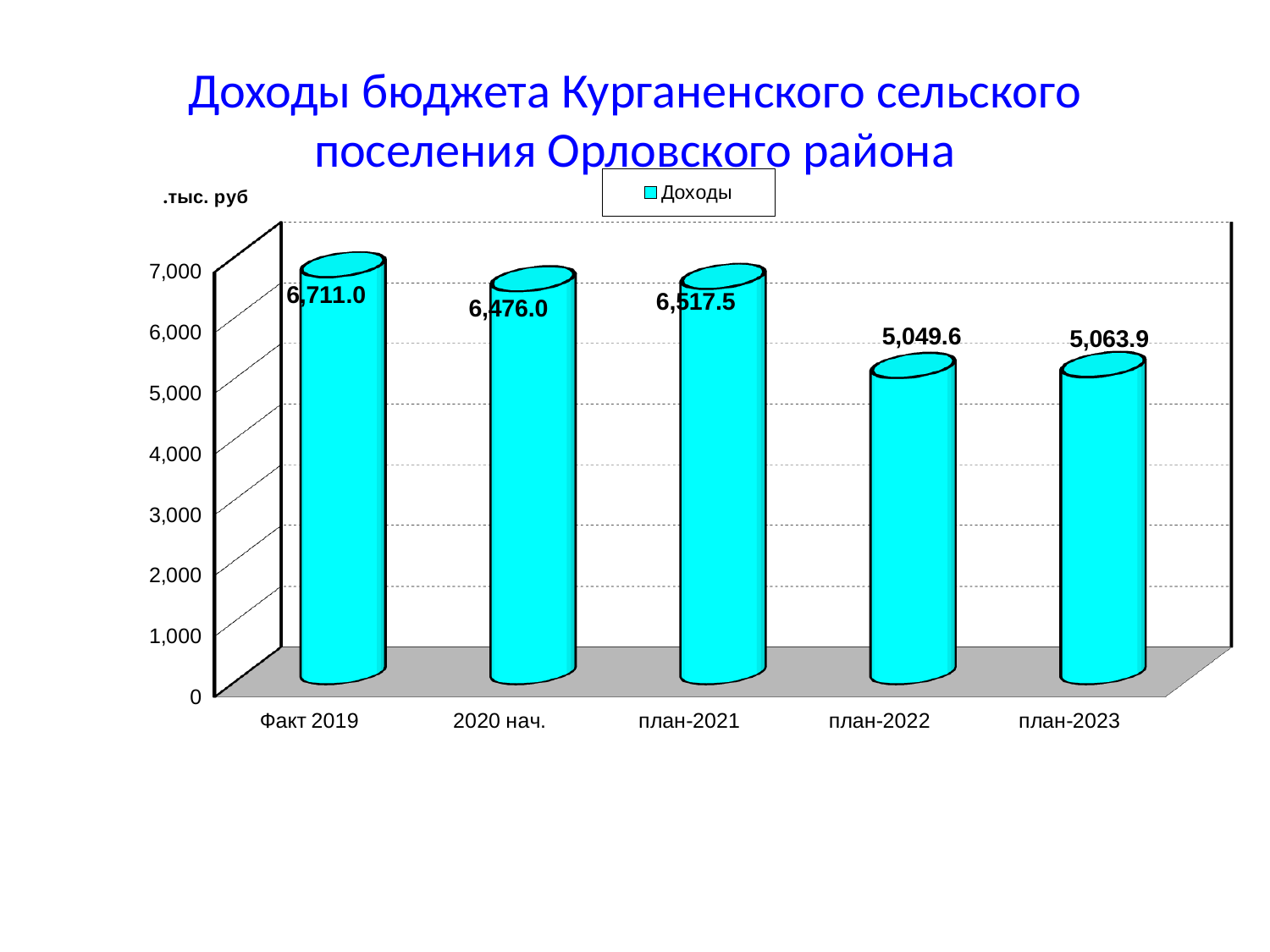
What series name does the legend show? Доходы What is the difference between the values for план-2021 and план-2022? 1,467.9 What is the value for 2020 нач.? 6,476.0 What is the difference between the values for Факт 2019 and 2020 нач.? 235.0 Which is larger, the value for план-2021 or the value for 2020 нач.? план-2021 What kind of chart is shown on the slide? bar chart Which category has the highest value? Факт 2019 Is the value for план-2023 greater or less than 6,000? less What is the value for план-2022? 5,049.6 Which category has the lowest value? план-2022 How many categories are shown on the x axis? 5 What is the value for Факт 2019? 6,711.0